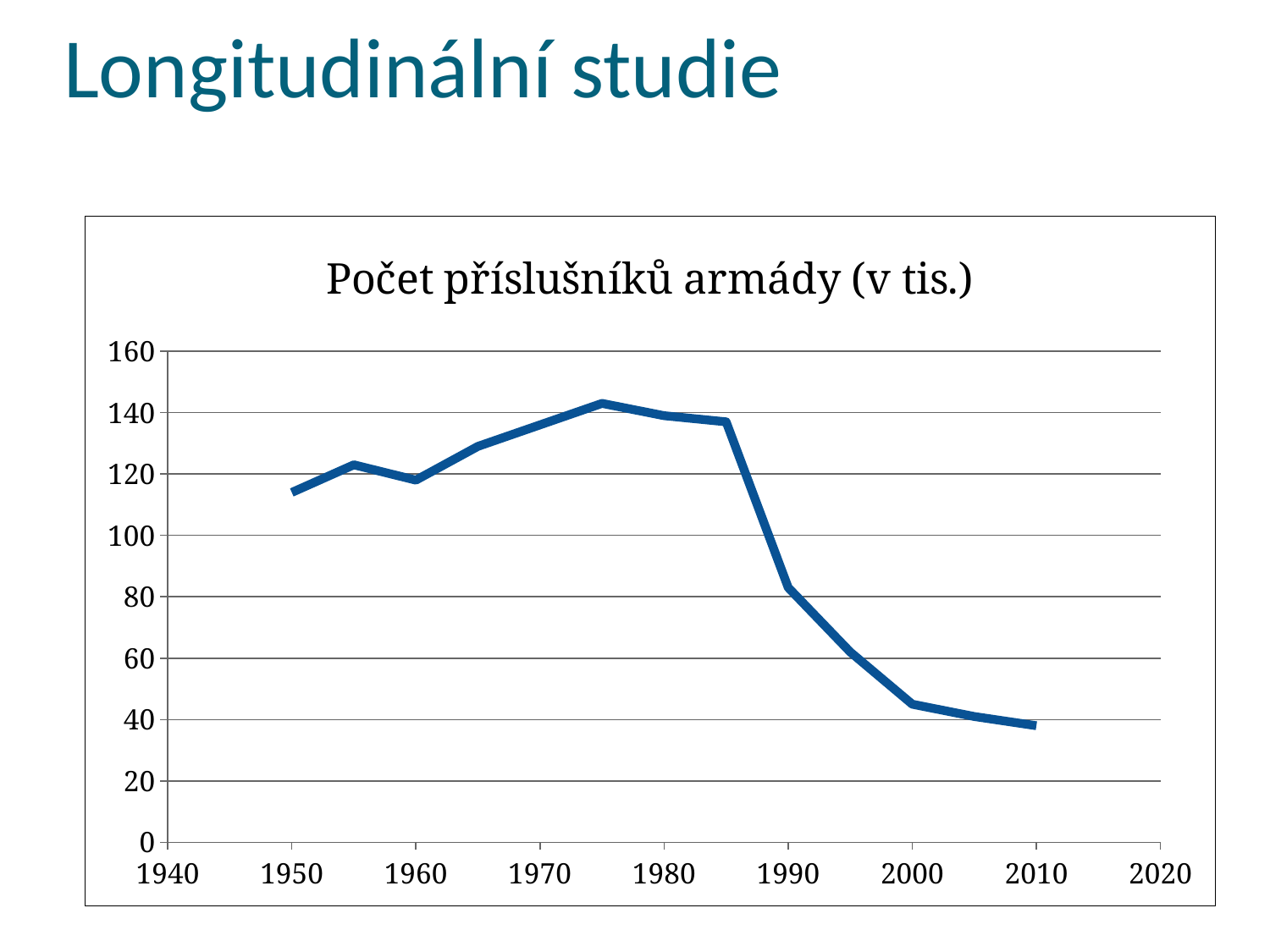
What kind of chart is shown on the slide? line chart Is the value for 1950 greater or less than 100? greater Is the value for 2000 greater or less than 60? less Is the value for 2010 greater or less than 60? less What is the title of the chart? Počet příslušníků armády (v tis.) In which year does the line reach its highest value? 1975 Which year has the larger value, 1975 or 2000? 1975 In which year does the line reach its lowest value? 2010 Do the values rise or fall between 1985 and 2010? fall